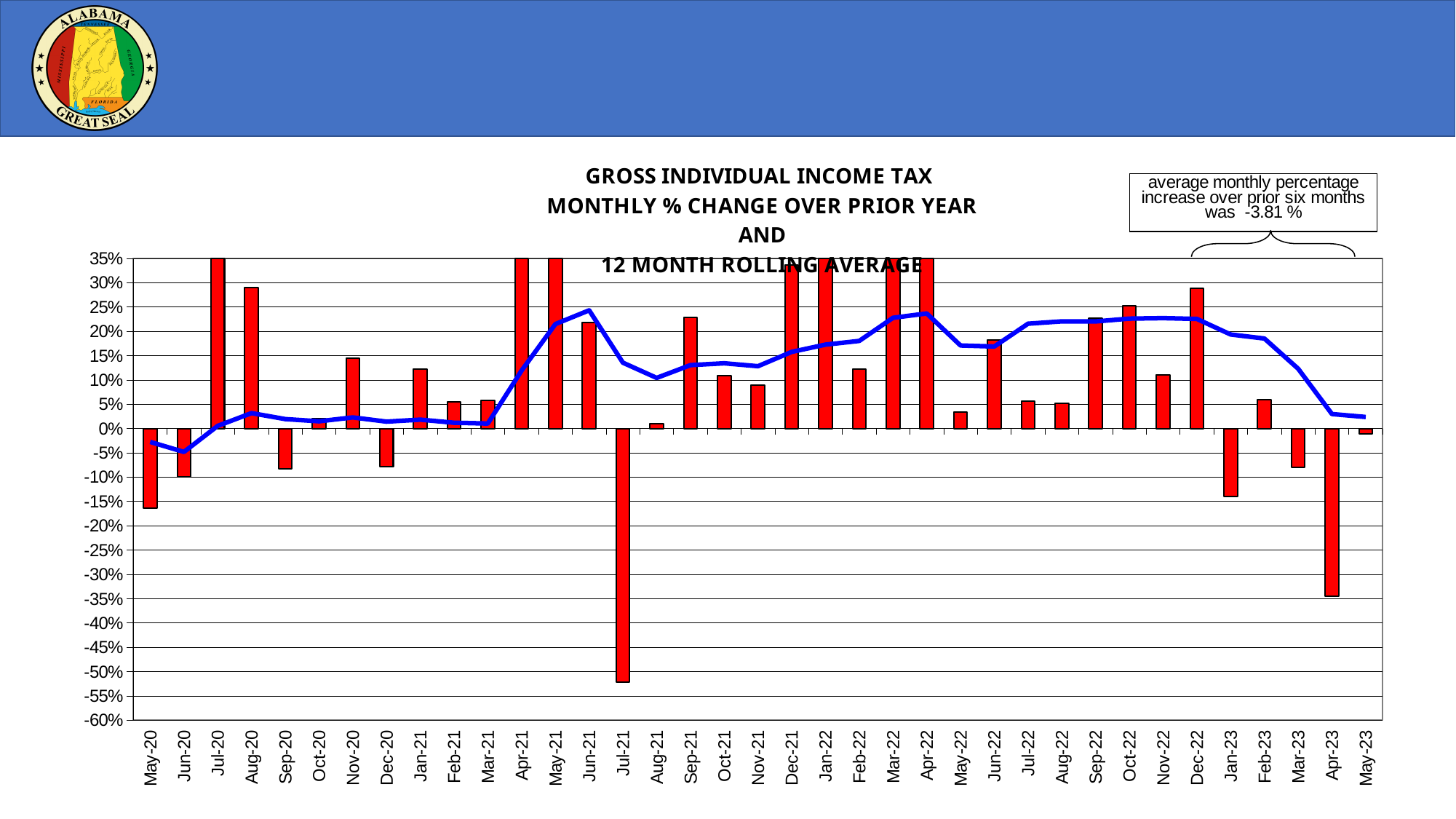
Is the bar value for Jul-21 greater or less than -40%? less Which bar is larger, Oct-22 or Nov-22? Oct-22 According to the annotation box, what was the average monthly percentage increase over the prior six months? -3.81 % Is the bar value for Apr-23 greater or less than -30%? less Does the 12 month rolling average line rise or fall from Dec-22 to May-23? Fall Which month has the lowest monthly % change bar? Jul-21 Which bar is larger, Aug-20 or Sep-21? Aug-20 How many months are plotted along the x axis? 37 Is the bar value for Nov-20 greater or less than 10%? greater What kind of chart is shown on the slide? A bar chart with a line overlay